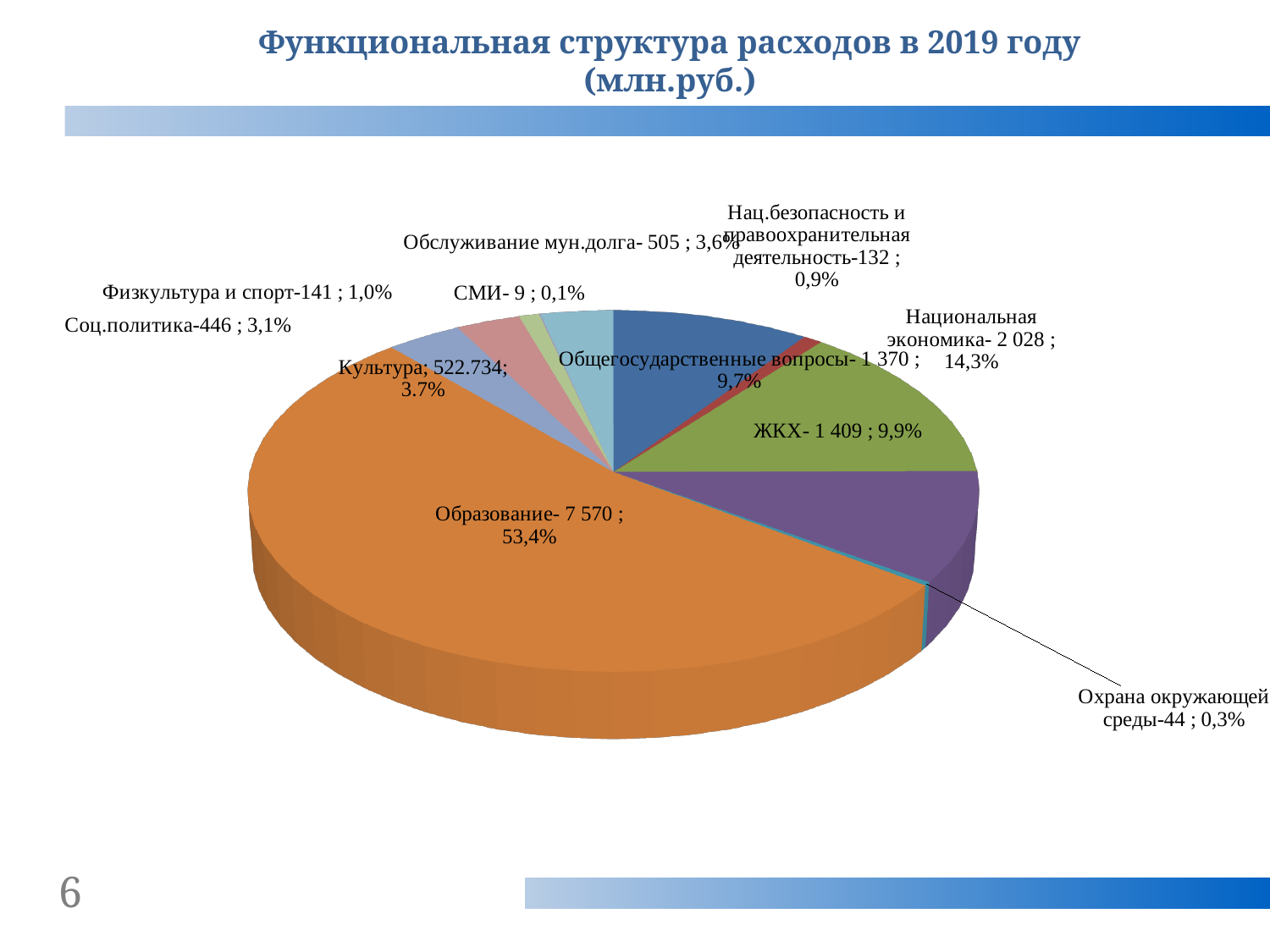
Which category has the smallest slice of the pie? СМИ What kind of chart is shown on the slide? pie chart Which category has the largest slice of the pie? Образование What share of the pie does ЖКХ take? 9,9% What is the difference between the values for Национальная экономика and ЖКХ? 619 What is the value for Обслуживание мун.долга? 505 What is the value for Национальная экономика? 2 028 Which is larger, ЖКХ or Общегосударственные вопросы? ЖКХ How many categories are shown in the pie chart? 11 What share of the pie does Образование take? 53,4% What is the value for Образование? 7 570 What is the title of the chart? Функциональная структура расходов в 2019 году (млн.руб.)